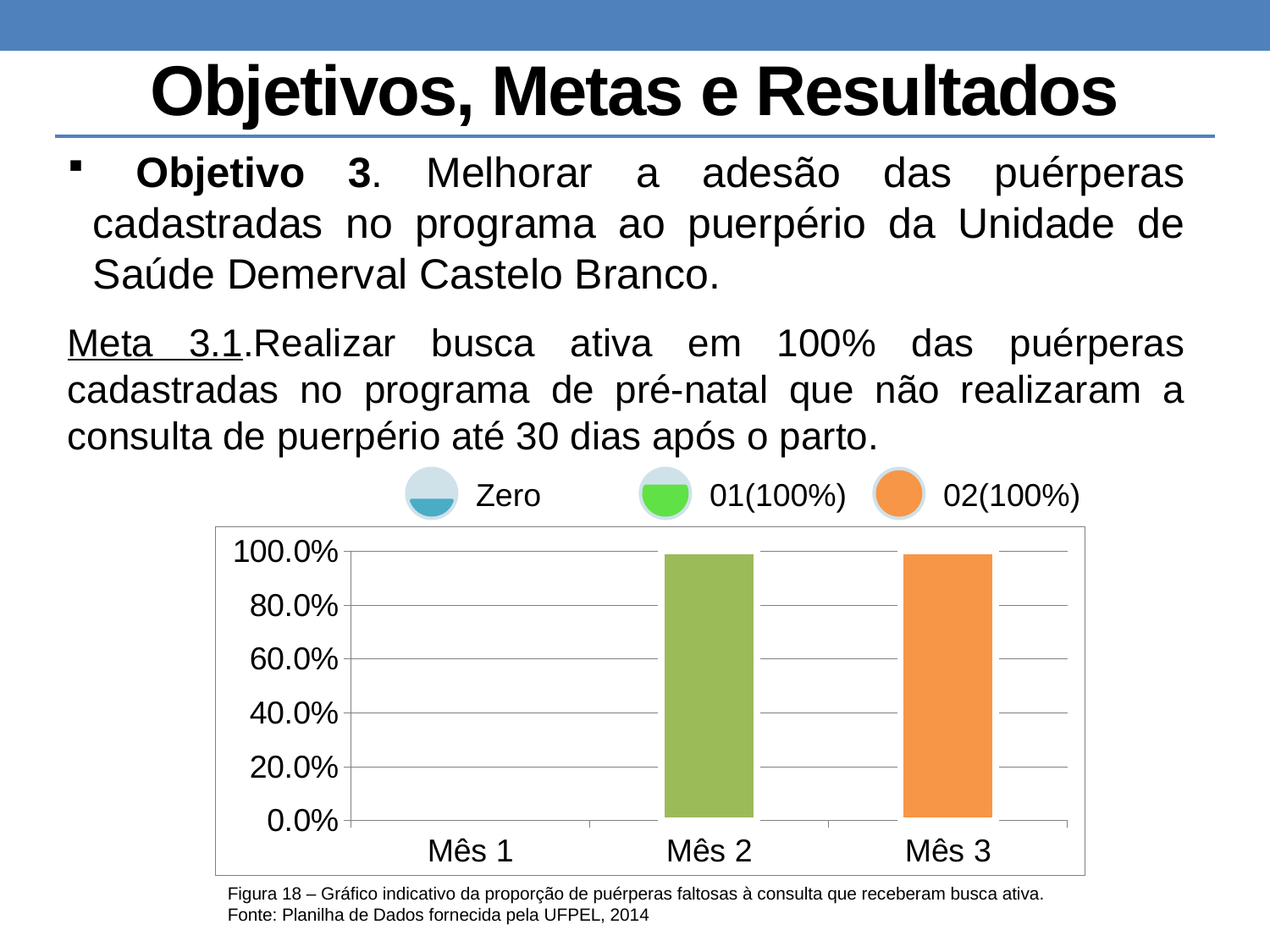
What is the value for Mês 3 in the chart? 100.0% How many categories are shown on the x axis of the chart? 3 Is the value for Mês 1 greater or less than 20.0%? less What is the difference between the value for Mês 2 and the value for Mês 1? 100.0% What kind of chart is shown on the slide? bar chart Which category has the lowest value in the chart? Mês 1 Is the value for Mês 2 greater or less than 80.0%? greater Which is larger, the value for Mês 1 or the value for Mês 2? Mês 2 What is the value for Mês 1 in the chart? 0.0% What is the value for Mês 2 in the chart? 100.0% Do the values rise or fall from Mês 1 to Mês 2? rise What colour is the bar for Mês 3? orange